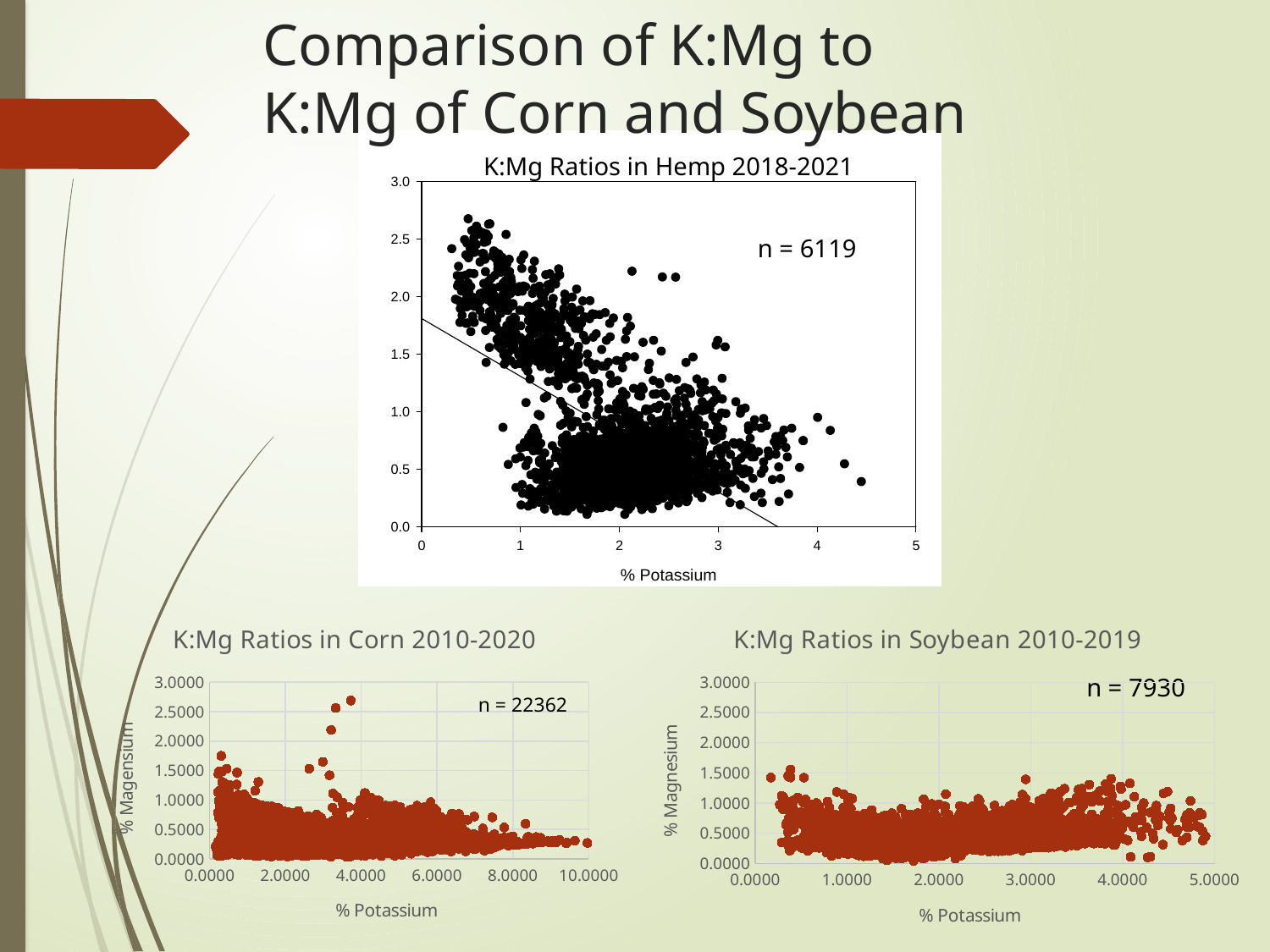
What kind of chart is the 'K:Mg Ratios in Hemp 2018-2021' chart? Scatter chart What is the x-axis label of the 'K:Mg Ratios in Corn 2010-2020' chart? % Potassium Which of the three charts on the slide has the smallest n? K:Mg Ratios in Hemp 2018-2021 In the 'K:Mg Ratios in Hemp 2018-2021' chart, does the fitted trend line rise or fall as % Potassium increases? Falls How many scatter charts are shown on the slide? 3 What is the difference between the n of the Soybean chart and the n of the Hemp chart? 1811 In the 'K:Mg Ratios in Hemp 2018-2021' chart, what is the value of n shown? n = 6119 Is the n for the Soybean chart larger or smaller than the n for the Hemp chart? Larger In the 'K:Mg Ratios in Soybean 2010-2019' chart, what is the value of n shown? n = 7930 Which of the three charts on the slide has the largest n? K:Mg Ratios in Corn 2010-2020 In the 'K:Mg Ratios in Corn 2010-2020' chart, what is the value of n shown? n = 22362 What is the difference between the n of the Corn chart and the n of the Soybean chart? 14432